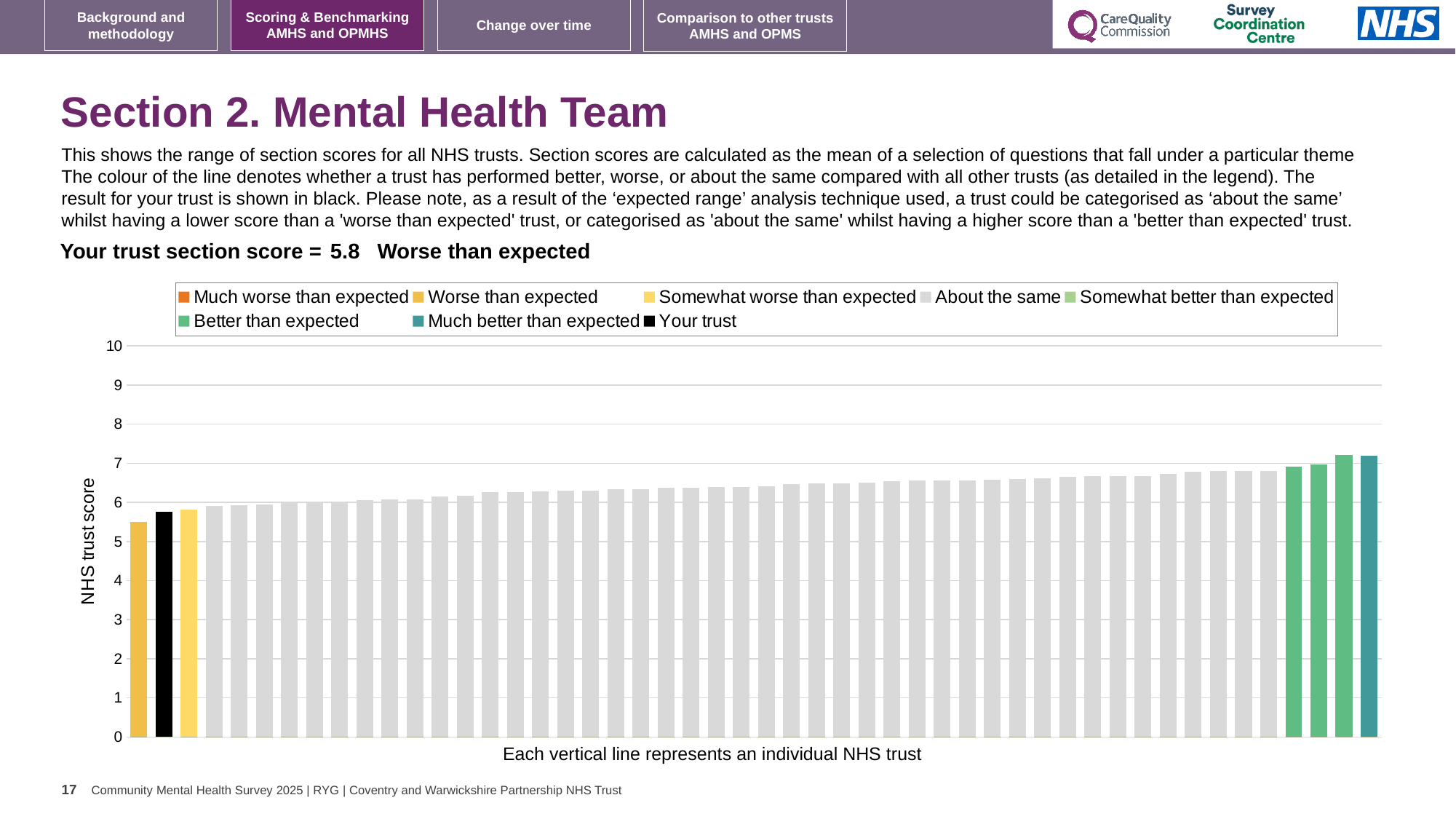
What kind of chart is shown on the slide? bar chart Do the bar values rise or fall from left to right along the x axis? rise According to the legend, what colour represents 'Your trust'? black Is the value of the tallest bar in the chart greater or less than 7? greater Is the value of the leftmost bar in the chart greater or less than 5? greater How many entries does the chart legend list? 8 Is the value of the black 'Your trust' bar greater or less than 6? less Which performance category is your trust placed in for this section? Worse than expected Which is taller: the black 'Your trust' bar or the leftmost bar? the black 'Your trust' bar What is the section score for your trust shown on the slide? 5.8